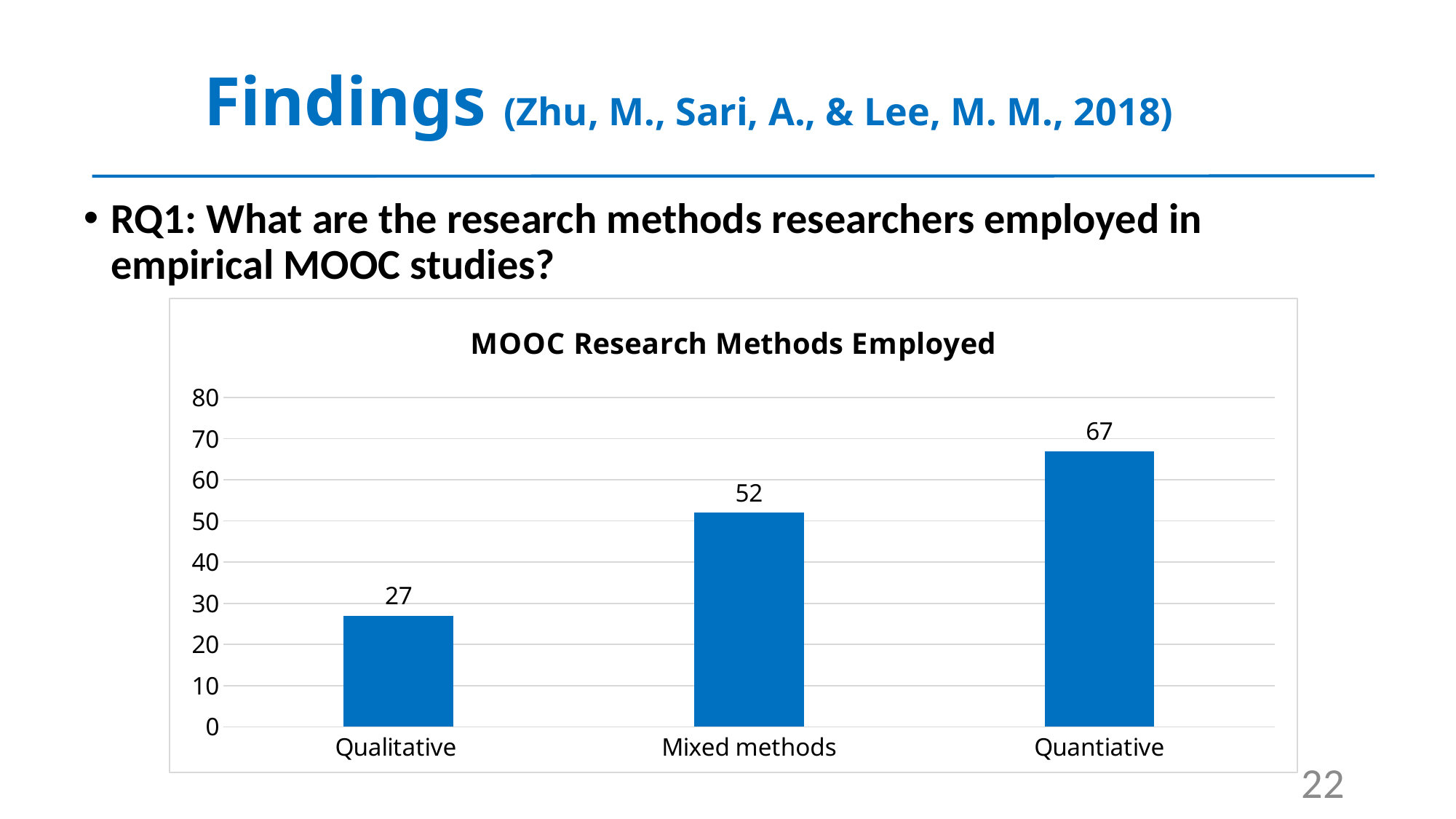
What kind of chart is shown on the slide? bar chart What is the value for Qualitative? 27 What is the difference between the values for Mixed methods and Qualitative? 25 Which category has the lowest value? Qualitative What is the value for Quantiative? 67 Which is larger, the value for Mixed methods or the value for Qualitative? Mixed methods Which category has the highest value? Quantiative How many categories are shown on the x axis? 3 What is the value for Mixed methods? 52 Is the value for Mixed methods greater or less than 50? greater What is the title of the chart? MOOC Research Methods Employed What is the difference between the values for Quantiative and Qualitative? 40